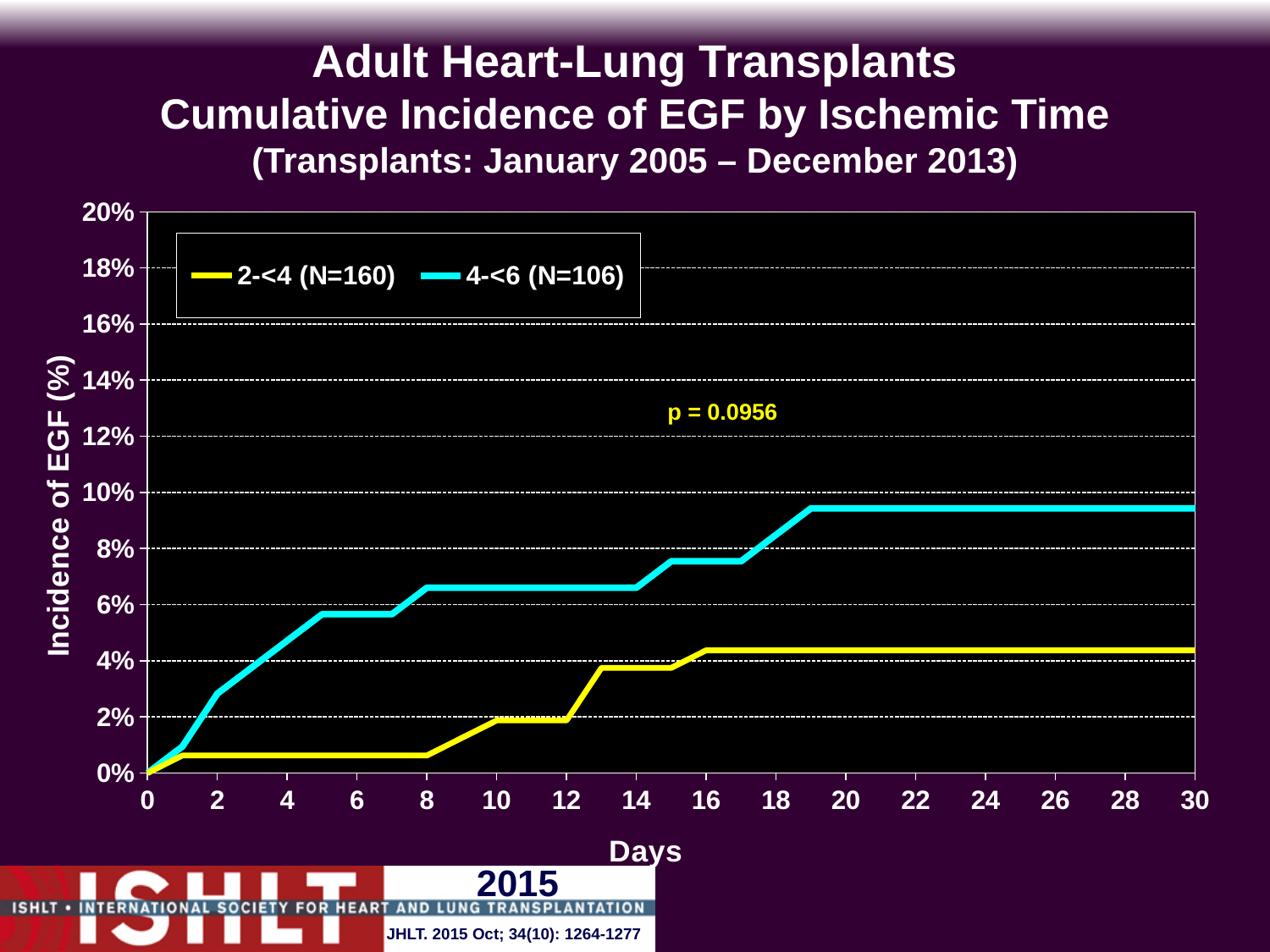
What colour is the line for the 4-<6 (N=106) series? cyan Is the value for the 2-<4 (N=160) series at day 30 greater or less than 6%? less Do the values for the 4-<6 (N=106) series rise or fall as the number of days increases? rise Which series has the lower cumulative incidence of EGF at day 16? 2-<4 (N=160) Is the value for the 4-<6 (N=106) series at day 30 greater or less than 8%? greater Is the value for the 4-<6 (N=106) series at day 4 greater or less than 6%? less Which series has the higher cumulative incidence of EGF at day 30? 4-<6 (N=106) What kind of chart is shown on the slide? line chart What p-value is printed on the chart? p = 0.0956 How many series does the legend list? 2